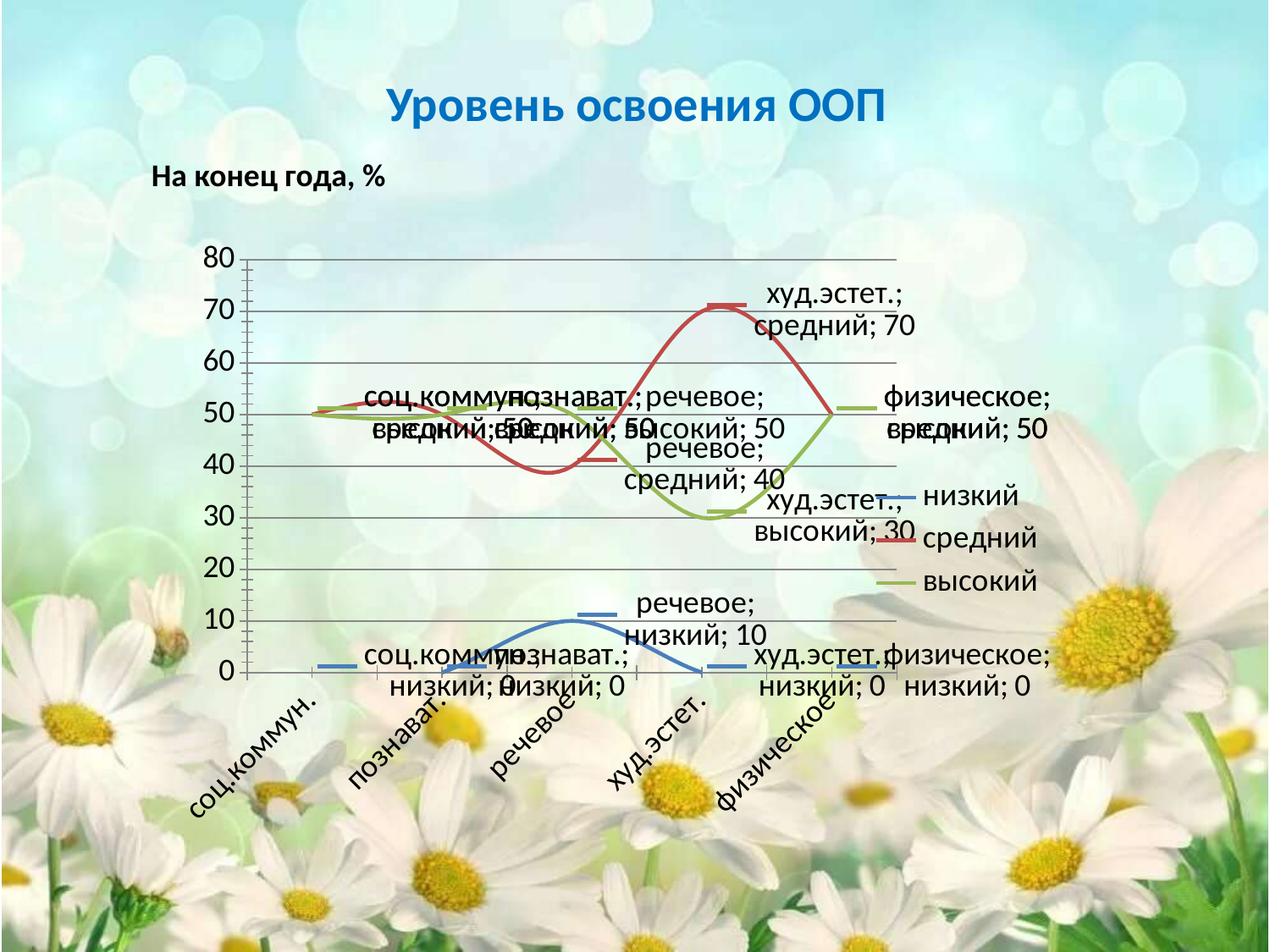
What kind of chart is shown on the slide? line chart What is the value of the высокий series for худ.эстет.? 30 What is the value of the низкий series for познават.? 0 How many series does the legend list? 3 How many categories are shown on the x axis? 5 For which category does the высокий series have its lowest value? худ.эстет. What is the difference between the средний values for худ.эстет. and речевое? 30 For худ.эстет., which series has the larger value, средний or высокий? средний For which category does the средний series reach its highest value? худ.эстет. What is the value of the низкий series for речевое? 10 What is the value of the средний series for речевое? 40 What is the value of the средний series for худ.эстет.? 70